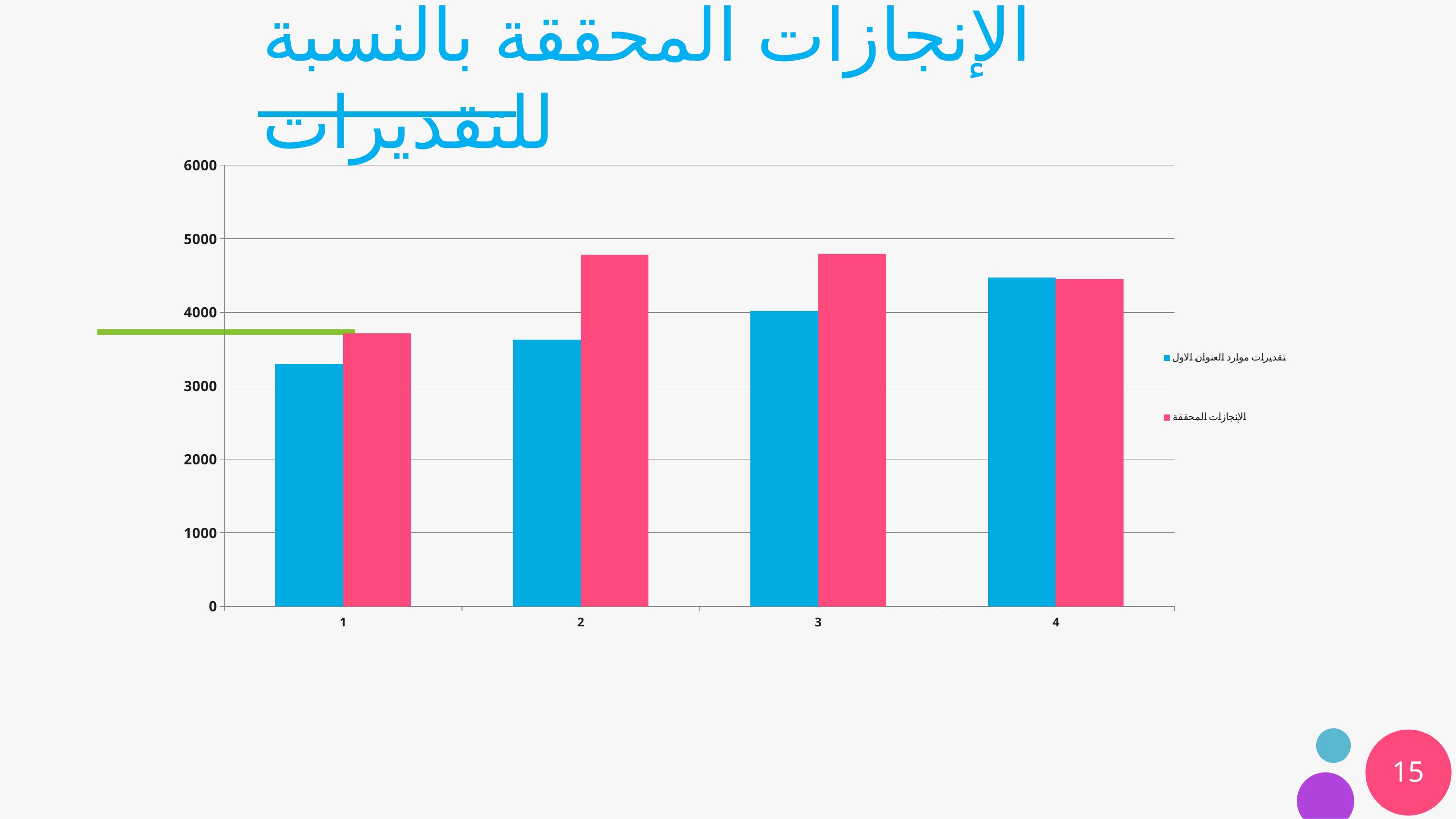
Is the value of تقديرات موارد العنوان الأول for category 4 greater or less than 4000? greater How many series does the legend list? 2 Is the value of الإنجازات المحققة for category 3 greater or less than 5000? less Do the values of تقديرات موارد العنوان الأول rise or fall from category 1 to category 4? rise Is the value of تقديرات موارد العنوان الأول for category 1 greater or less than 4000? less Which category has the highest value for تقديرات موارد العنوان الأول? 4 What kind of chart is shown on the slide? Bar chart For category 2, which series has the larger value: تقديرات موارد العنوان الأول or الإنجازات المحققة? الإنجازات المحققة Which category has the lowest value for الإنجازات المحققة? 1 How many categories are shown on the x axis? 4 What colour are the bars for الإنجازات المحققة? Pink